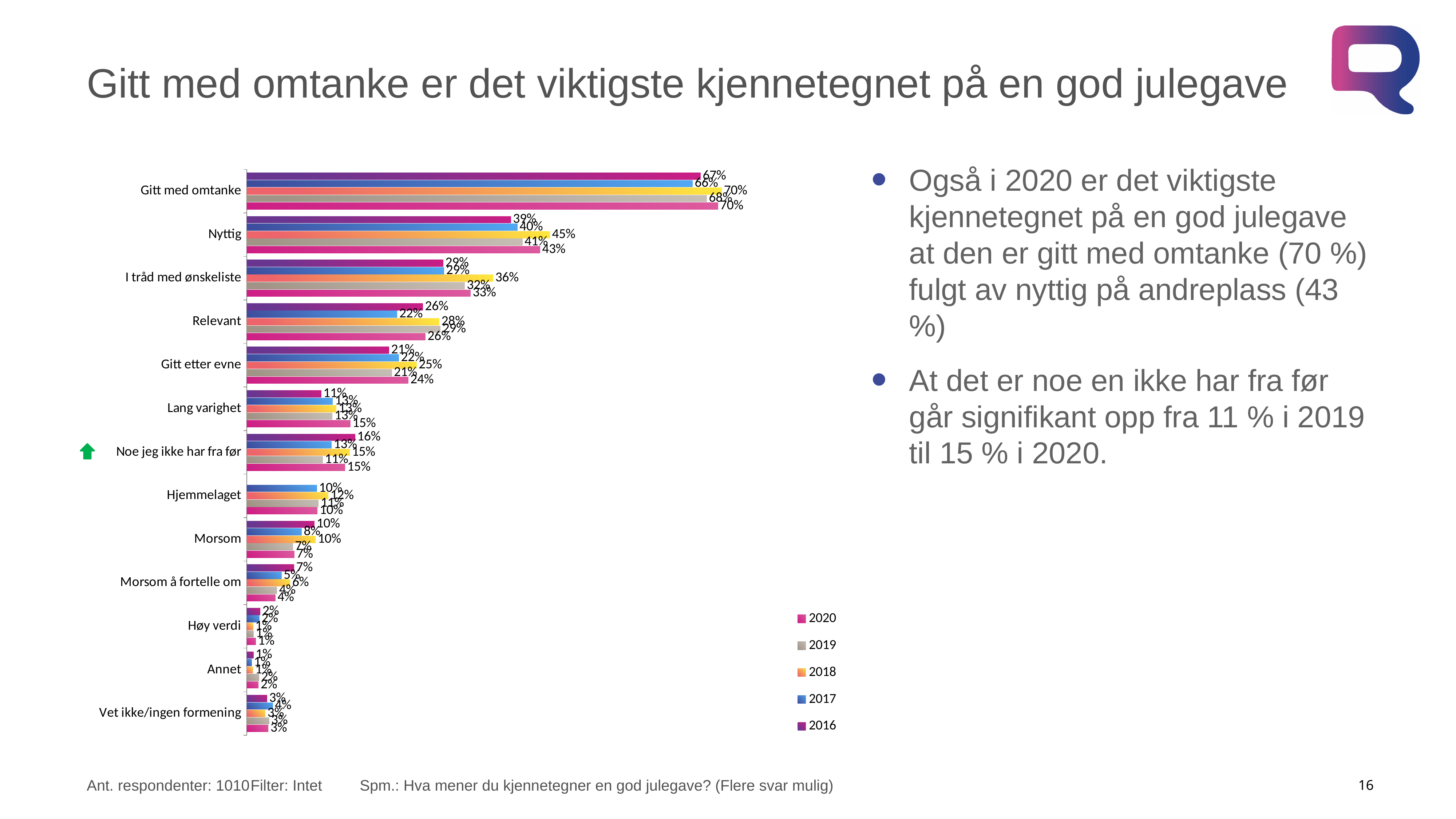
Which category has the highest 2020 value? Gitt med omtanke For "Nyttig", which is larger: the 2018 value or the 2020 value? 2018 What is the 2018 value for "I tråd med ønskeliste"? 36% What kind of chart is shown on the slide? Bar chart What is the 2020 value for "Gitt med omtanke"? 70% What is the difference between the 2020 values for "Gitt med omtanke" and "Nyttig"? 27 percentage points How many categories are shown on the chart? 13 What is the 2019 value for "Noe jeg ikke har fra før"? 11% What is the 2020 value for "Nyttig"? 43% Which year is listed first in the legend? 2020 How many series does the legend list? 5 By how much did "Noe jeg ikke har fra før" change from 2019 to 2020? 4 percentage points